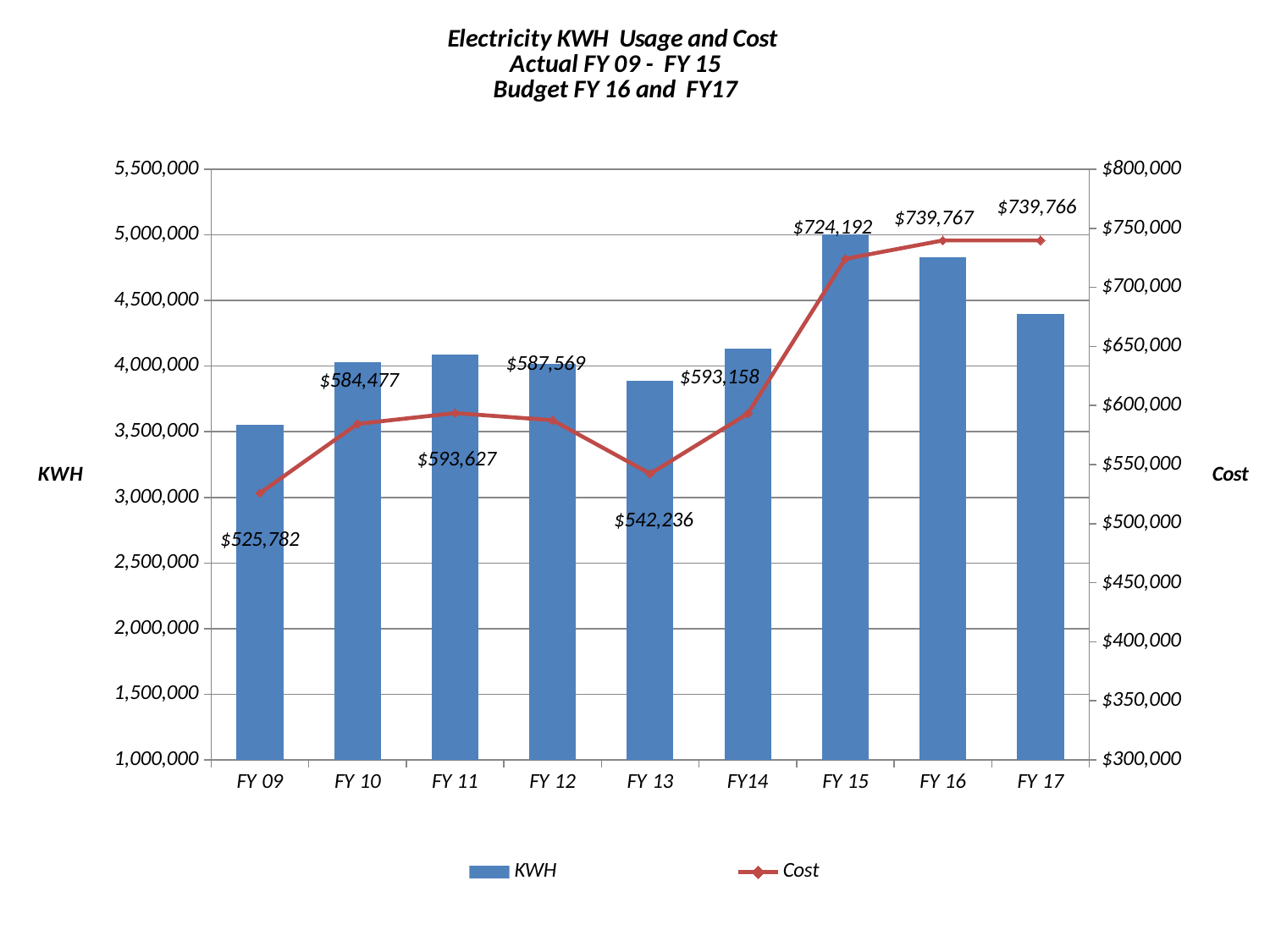
Is the KWH value for FY 09 greater or less than 4,000,000? less What is the Cost value for FY 10? $584,477 What is the difference in Cost between FY 15 and FY14? $131,034 Is the KWH value for FY 16 greater or less than 4,500,000? greater What is the Cost value for FY 13? $542,236 How many series does the legend list? 2 Which fiscal year has the lowest Cost? FY 09 Which fiscal year has the highest KWH bar? FY 15 Which has the higher Cost, FY 11 or FY 12? FY 11 What is the difference in Cost between FY 10 and FY 09? $58,695 How many fiscal years are shown on the x axis? 9 What is the Cost value for FY 15? $724,192